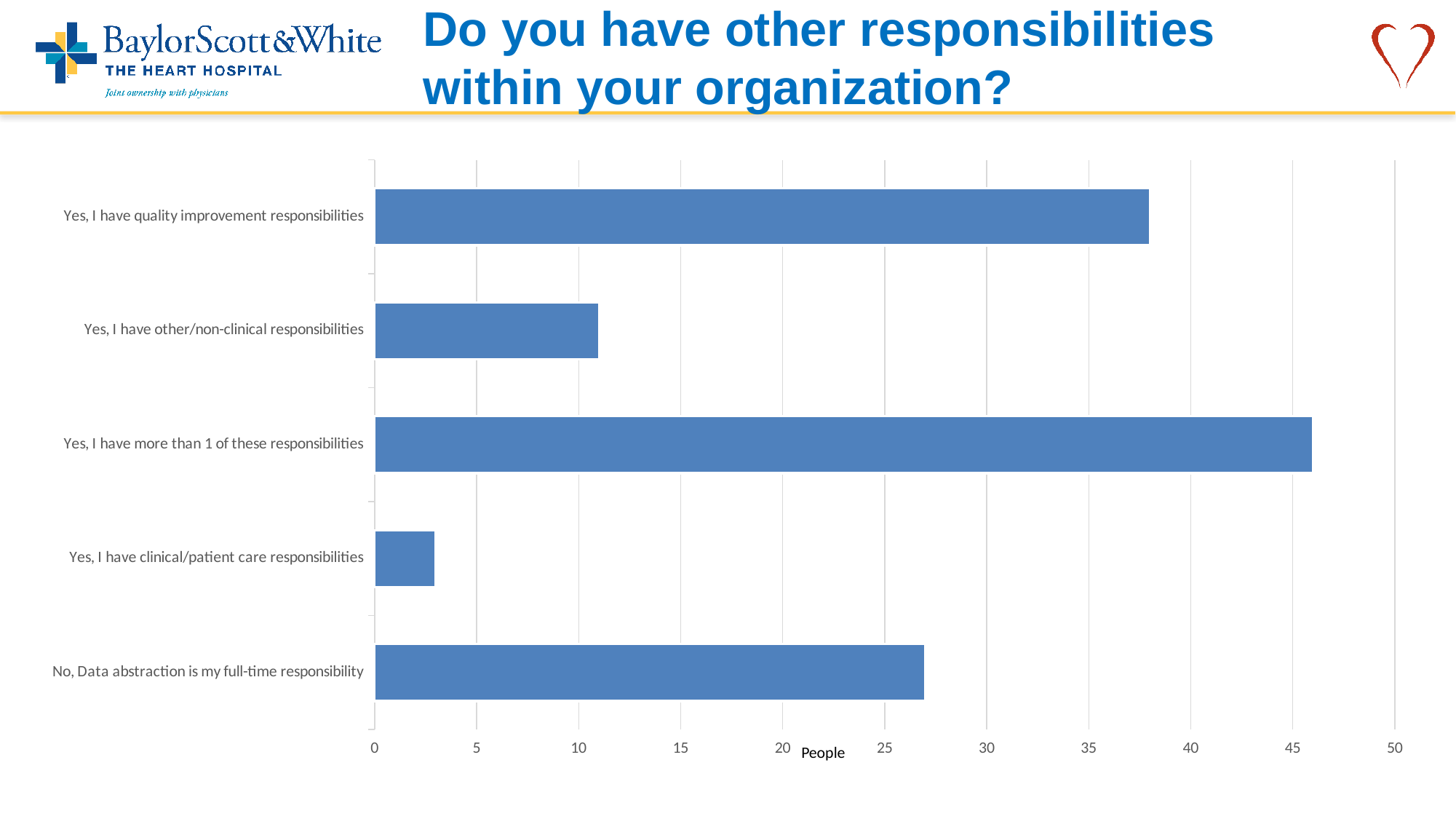
Which response category has the highest value? Yes, I have more than 1 of these responsibilities What is the label on the horizontal axis of the chart? People Is the value for "Yes, I have clinical/patient care responsibilities" greater or less than 5? less What kind of chart is shown on the slide? bar chart Is the value for "Yes, I have other/non-clinical responsibilities" greater or less than 15? less How many response categories are plotted in the chart? 5 Which is larger: the value for "Yes, I have quality improvement responsibilities" or the value for "No, Data abstraction is my full-time responsibility"? Yes, I have quality improvement responsibilities Is the value for "No, Data abstraction is my full-time responsibility" greater or less than 25? greater Which response category has the lowest value? Yes, I have clinical/patient care responsibilities What is the maximum value shown on the horizontal axis? 50